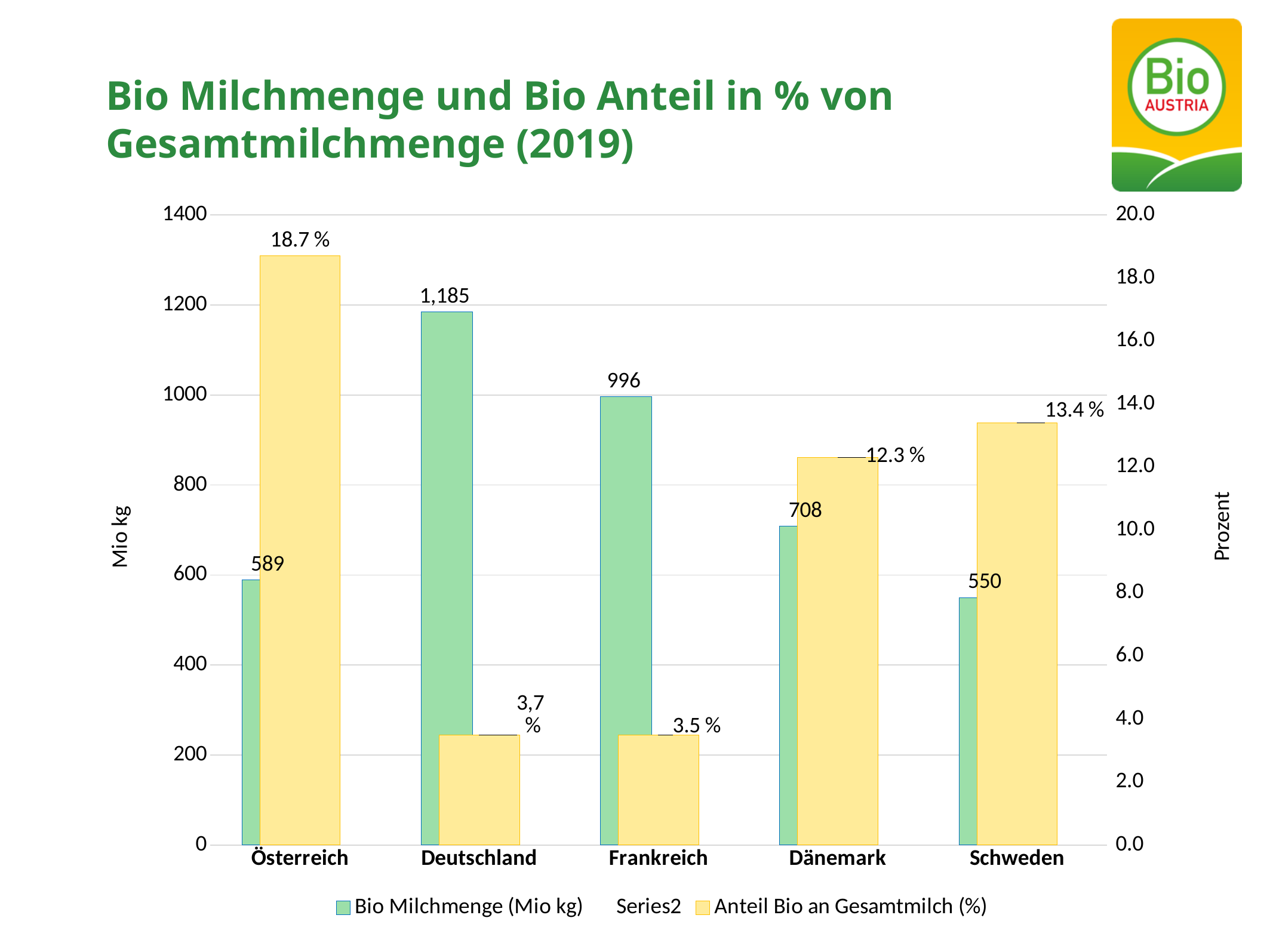
What is the Bio Milchmenge (Mio kg) value for Schweden? 550 What kind of chart is shown on the slide? bar chart Which country has the highest Bio Milchmenge (Mio kg)? Deutschland What is the Bio Milchmenge (Mio kg) value for Deutschland? 1,185 What is the Anteil Bio an Gesamtmilch (%) value for Dänemark? 12.3 % What is the Anteil Bio an Gesamtmilch (%) value for Österreich? 18.7 % What is the difference in Bio Milchmenge (Mio kg) between Frankreich and Dänemark? 288 How many countries are shown on the x axis of the chart? 5 Is the Bio Milchmenge (Mio kg) value for Österreich greater or less than 600? less Which country has a larger Anteil Bio an Gesamtmilch (%), Schweden or Dänemark? Schweden How many entries does the chart legend list? 3